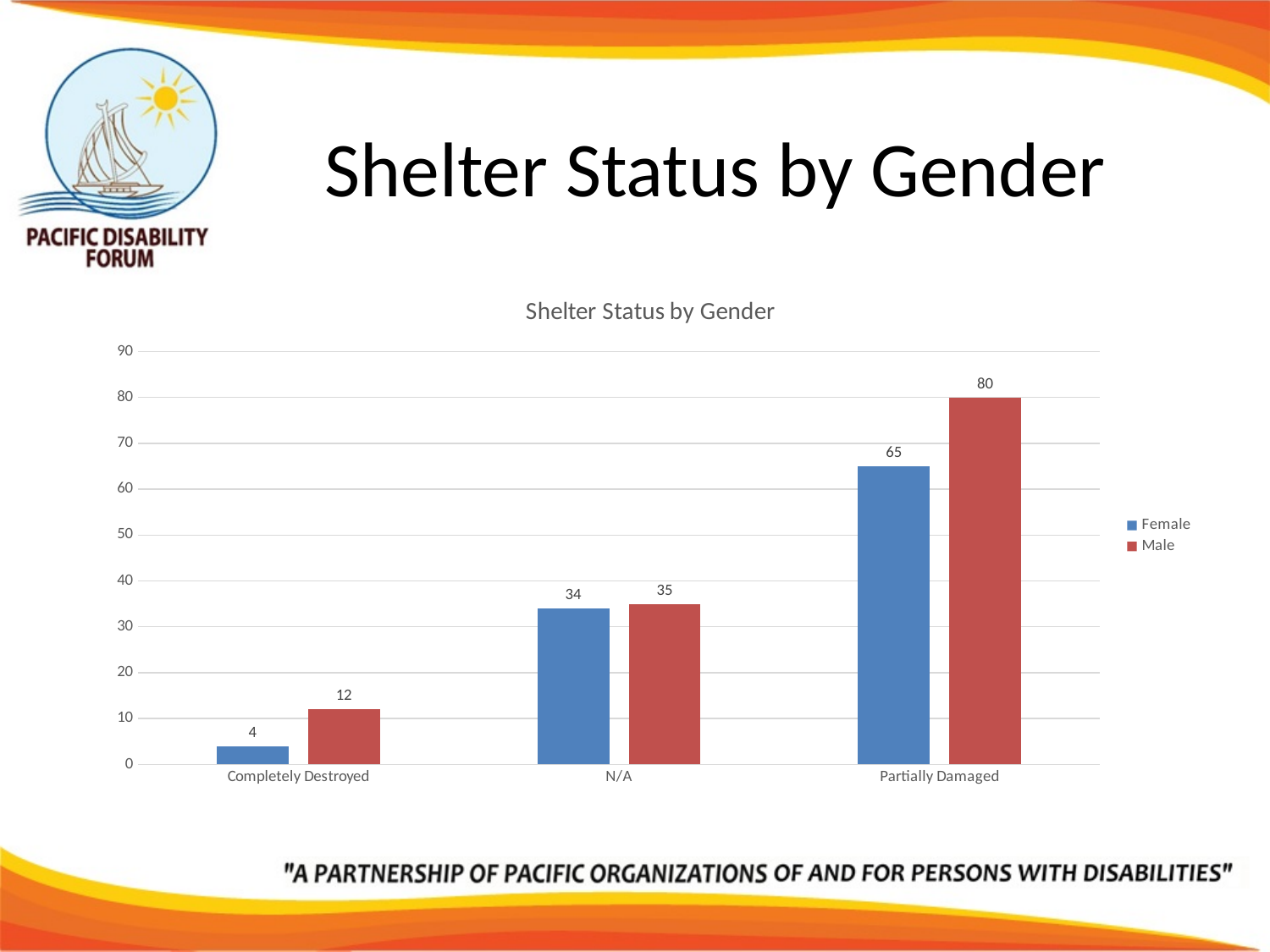
Which is larger for Completely Destroyed, the Female value or the Male value? Male Which category has the highest Female value? Partially Damaged What is the Male value for N/A? 35 Is the Female value for Partially Damaged greater or less than 60? greater What is the difference between the Male and Female values for Completely Destroyed? 8 What is the Male value for Partially Damaged? 80 Which category has the lowest Male value? Completely Destroyed What is the difference between the Male and Female values for Partially Damaged? 15 What kind of chart is shown on the slide? Bar chart What is the Female value for Completely Destroyed? 4 How many series does the legend list? 2 How many categories are shown on the x axis? 3